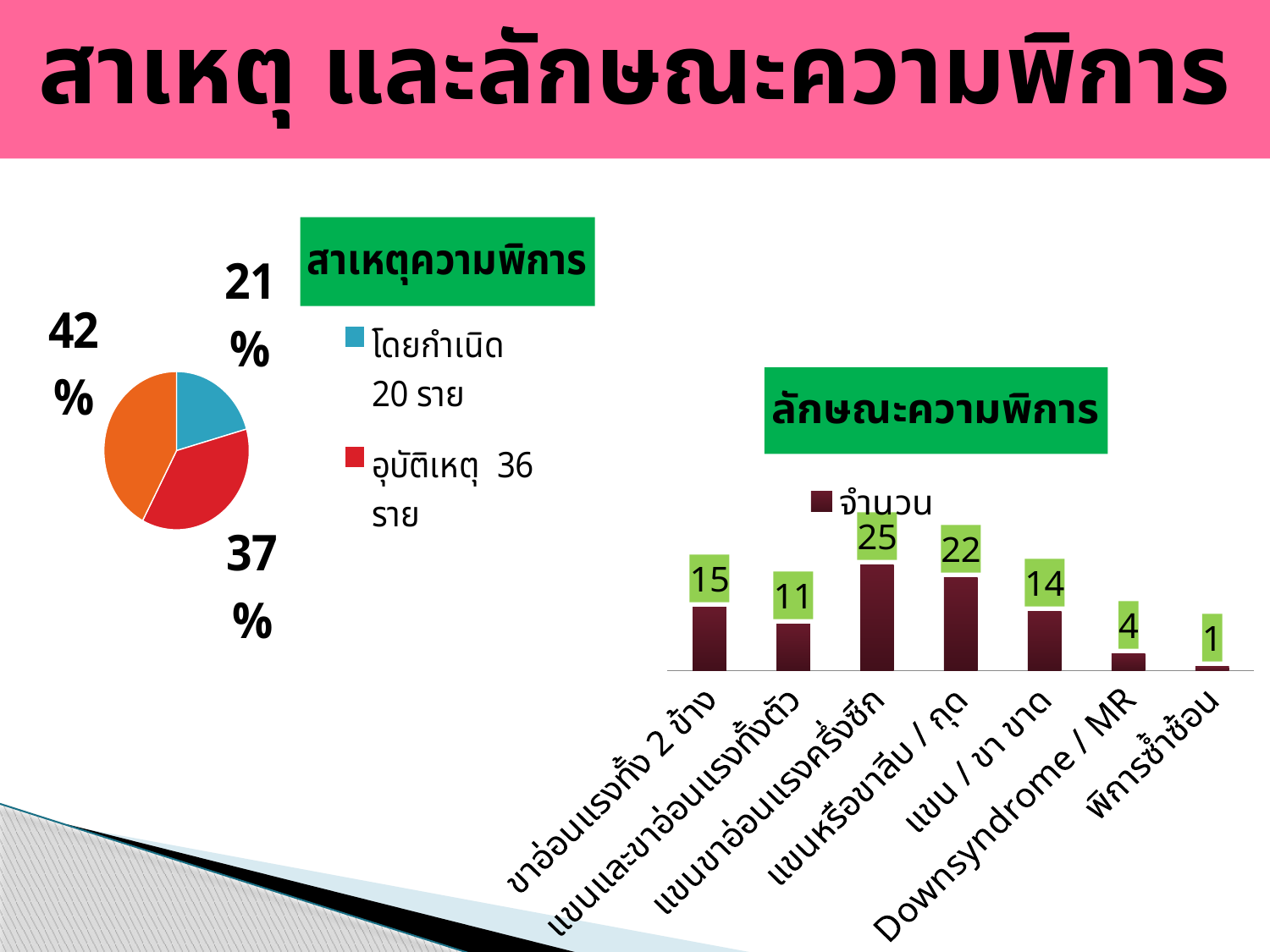
In the bar chart titled ลักษณะความพิการ, which category has the lowest value? พิการซ้ำซ้อน In the pie chart titled สาเหตุความพิการ, what share does the อุบัติเหตุ slice have? 37% In the bar chart titled ลักษณะความพิการ, what is the value for Downsyndrome / MR? 4 What kind of chart is the chart titled สาเหตุความพิการ? pie chart How many categories are shown in the bar chart titled ลักษณะความพิการ? 7 In the bar chart titled ลักษณะความพิการ, what is the difference between the values for แขนหรือขาลีบ / กุด and แขนและขาอ่อนแรงทั้งตัว? 11 In the bar chart titled ลักษณะความพิการ, which is larger: ขาอ่อนแรงทั้ง 2 ข้าง or แขนและขาอ่อนแรงทั้งตัว? ขาอ่อนแรงทั้ง 2 ข้าง In the bar chart titled ลักษณะความพิการ, which category has the highest value? แขนขาอ่อนแรงครึ่งซีก In the bar chart titled ลักษณะความพิการ, what is the value for แขน / ขา ขาด? 14 What series name does the legend of the bar chart titled ลักษณะความพิการ show? จำนวน In the bar chart titled ลักษณะความพิการ, what is the value for แขนขาอ่อนแรงครึ่งซีก? 25 In the pie chart titled สาเหตุความพิการ, what share does the โดยกำเนิด slice have? 21%